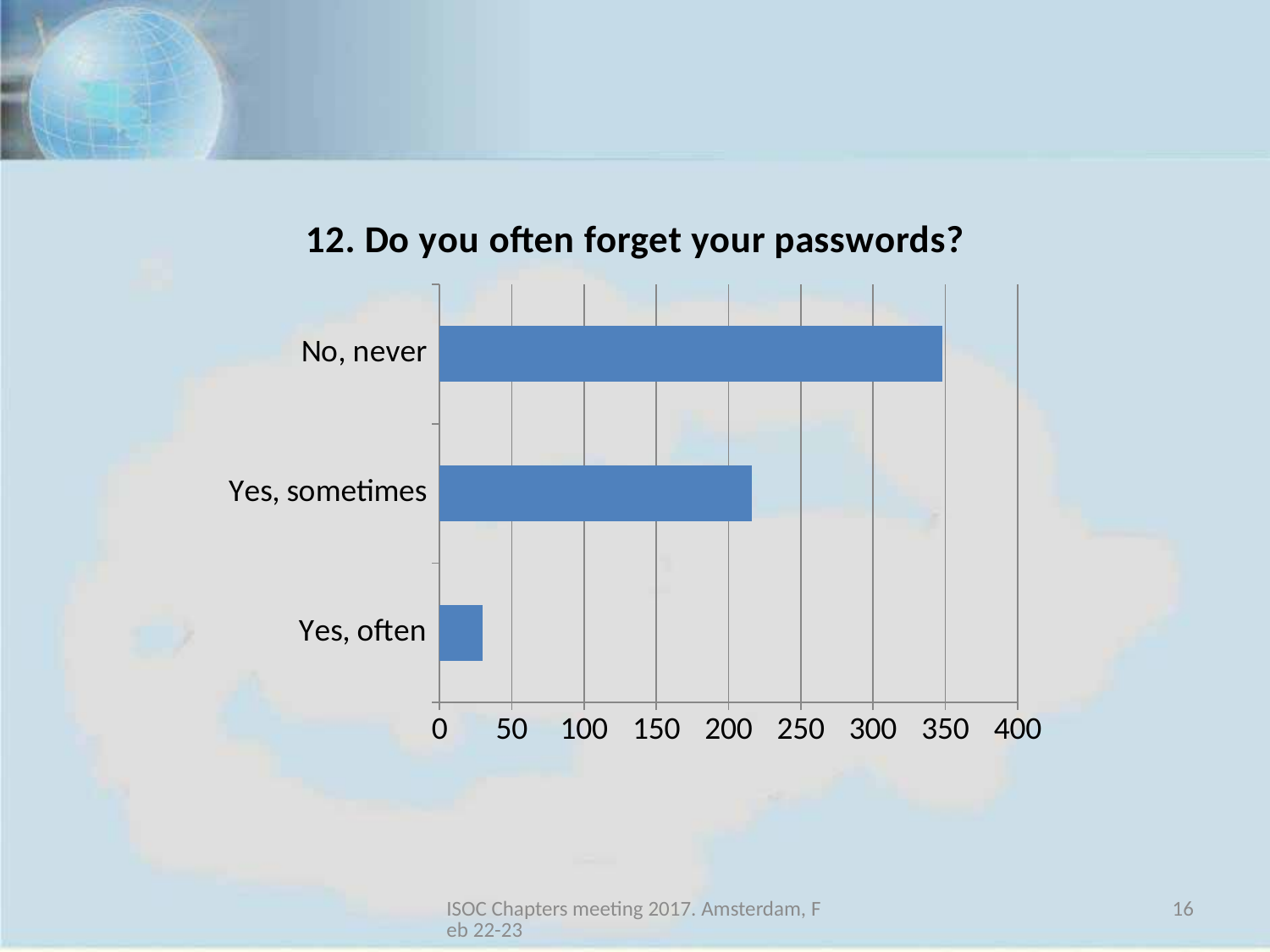
What kind of chart is shown on the slide? bar chart Is the value for "Yes, often" greater or less than 50? less What is the maximum value shown on the horizontal axis? 400 Is the value for "No, never" greater or less than 300? greater How many categories does the chart show? 3 Which is larger, the value for "Yes, sometimes" or the value for "Yes, often"? Yes, sometimes What is the title of the chart? 12. Do you often forget your passwords? Is the value for "Yes, sometimes" greater or less than 250? less Which is larger, the value for "No, never" or the value for "Yes, sometimes"? No, never Which category has the lowest value? Yes, often Which category has the highest value? No, never